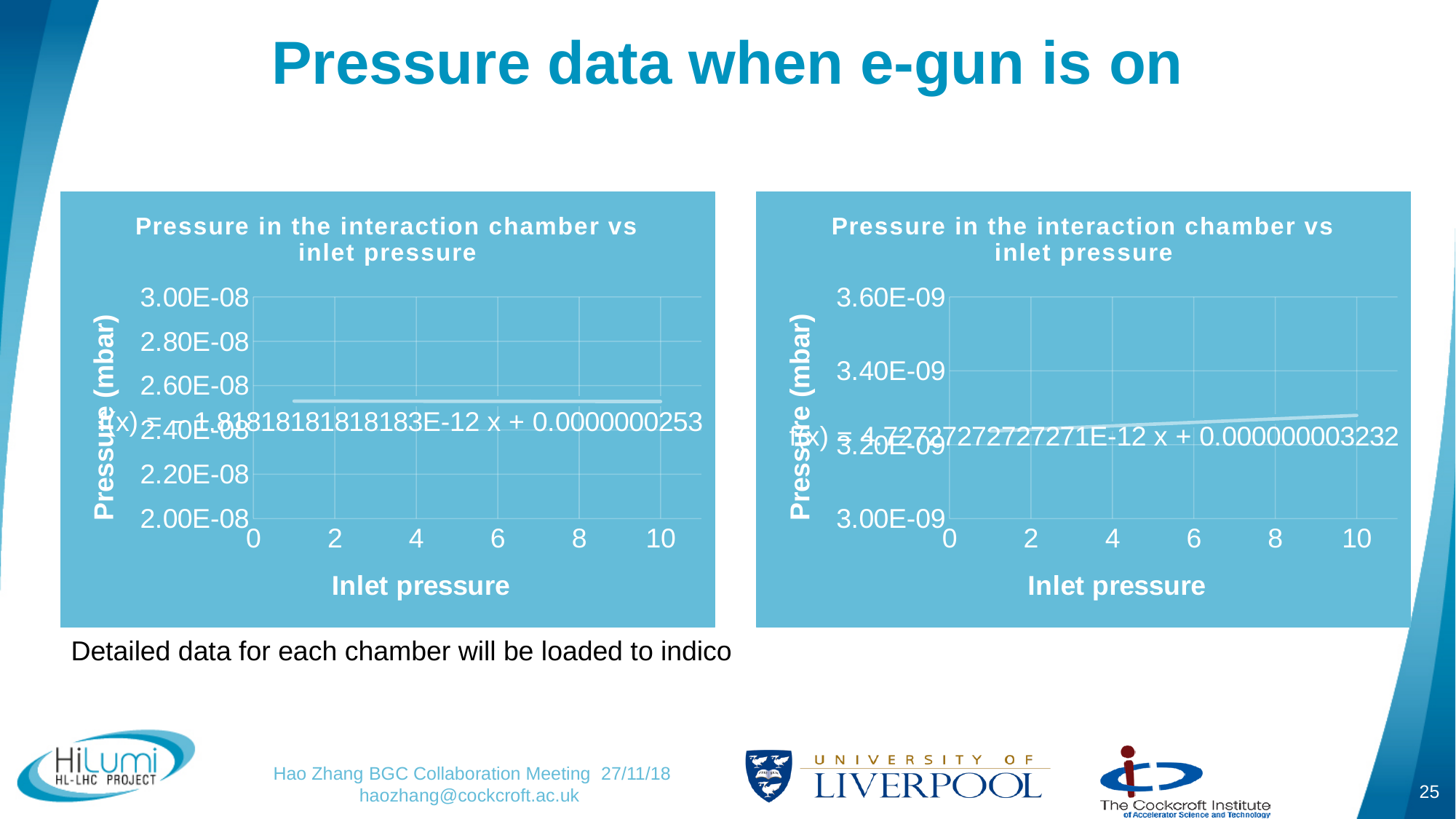
What is the highest y-axis tick value shown on the left chart? 3.00E-08 In the right chart, is the plotted pressure at inlet pressure 10 greater or less than 3.20E-09? greater In the left chart, is the plotted pressure at inlet pressure 4 greater or less than 2.40E-08? greater What is the x-axis title of the right chart? Inlet pressure What is the intercept value in the fitted equation shown on the right chart? 0.000000003232 In the left chart, does the plotted line rise or fall as inlet pressure increases from 0 to 10? fall What is the title of the left chart? Pressure in the interaction chamber vs inlet pressure What is the intercept value in the fitted equation shown on the left chart? 0.0000000253 What is the lowest y-axis tick value shown on the right chart? 3.00E-09 In the left chart, is the plotted pressure at inlet pressure 8 greater or less than 2.60E-08? less In the right chart, does the plotted line rise or fall as inlet pressure increases from 0 to 10? rise